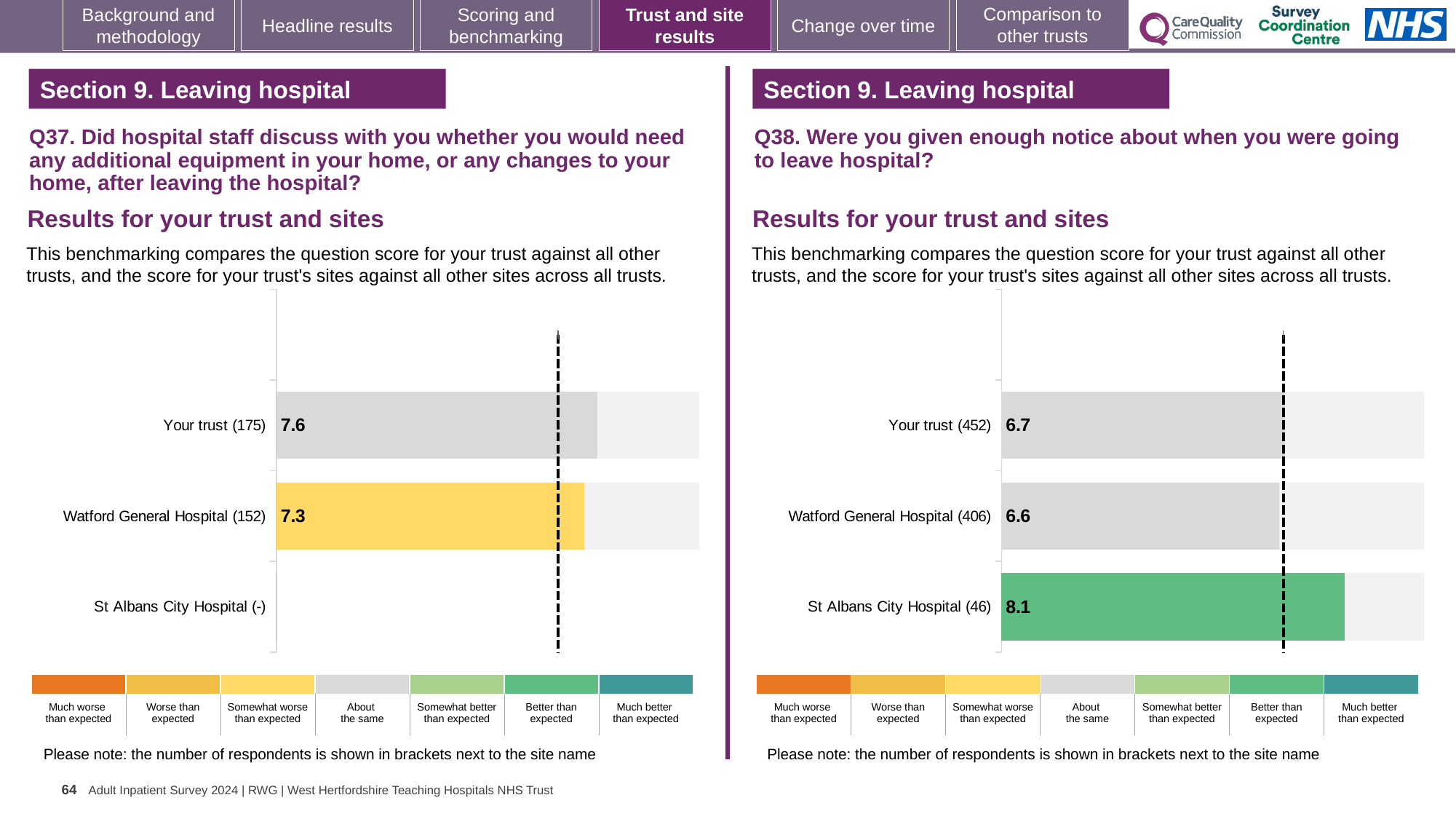
What type of chart is used in the Q37 chart on the left? Bar chart In the Q38 chart on the right, which site or trust has the lowest score? Watford General Hospital How many respondents are shown in brackets for Your trust in the Q38 chart on the right? 452 In the Q37 chart on the left, what is the score for Your trust? 7.6 In the Q38 chart on the right, what is the score for Watford General Hospital? 6.6 In the Q38 chart on the right, which site or trust has the highest score? St Albans City Hospital In the Q37 chart on the left, which is larger: the score for Your trust or the score for Watford General Hospital? Your trust In the Q38 chart on the right, what is the score for St Albans City Hospital? 8.1 In the Q37 chart on the left, what is the score for Watford General Hospital? 7.3 In the Q37 chart on the left, what is the difference between the Your trust score and the Watford General Hospital score? 0.3 In the Q38 chart on the right, what is the difference between the St Albans City Hospital score and the Your trust score? 1.4 In the Q37 chart on the left, what colour is the bar for Watford General Hospital? Yellow